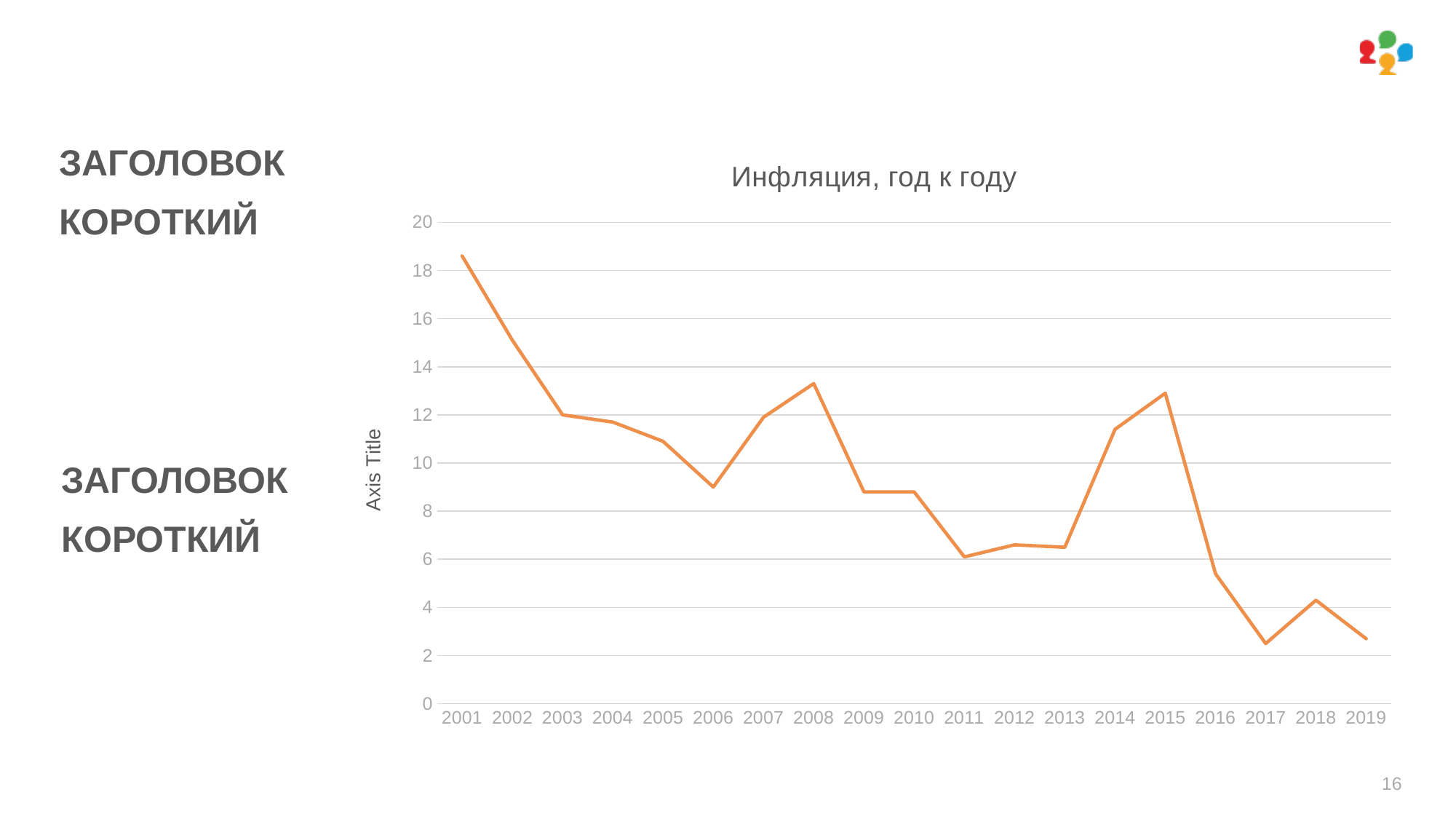
Which is larger, the value for 2013 or the value for 2014? 2014 Is the value for 2017 greater or less than 4? less Is the value for 2006 greater or less than 10? less What kind of chart is shown on the slide? line chart Which is larger, the value for 2002 or the value for 2003? 2002 What is the title of the chart? Инфляция, год к году Is the value for 2014 greater or less than 10? greater How many years are plotted along the x axis of the chart? 19 Which year has the highest value on the chart? 2001 Overall, do the values rise or fall from 2001 to 2019? fall